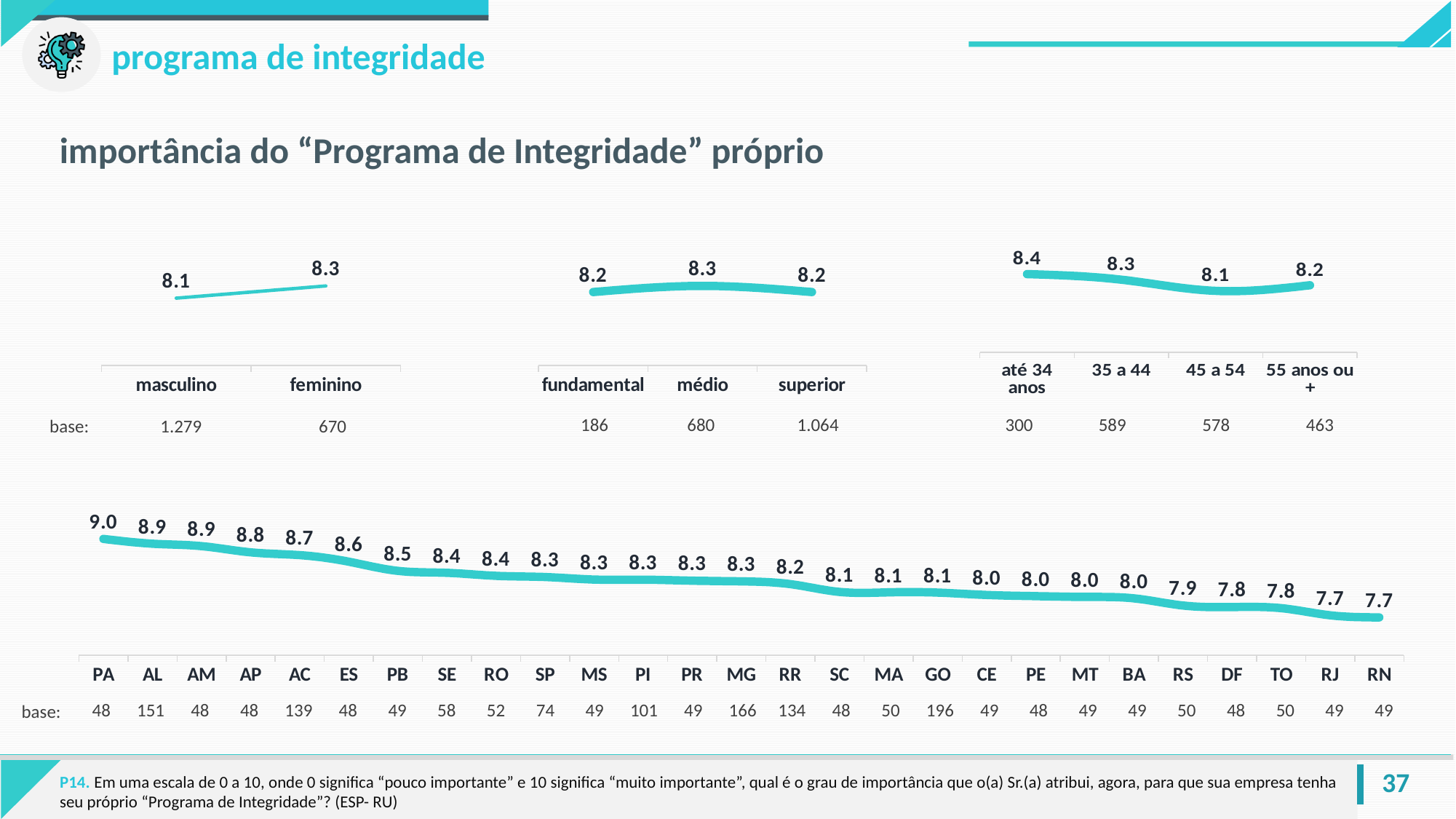
In the states chart at the bottom, how many states are plotted? 27 In the gender chart (masculino/feminino), what is the value for feminino? 8.3 In the gender chart, what is the difference between the feminino and masculino values? 0.2 In the age chart, how many age groups are plotted? 4 In the education chart (fundamental/médio/superior), which category has the highest value? médio In the gender chart, which group has the higher value, masculino or feminino? feminino In the states chart at the bottom, do the values rise or fall from left to right? fall In the states chart at the bottom, which state has the highest value? PA In the age chart, which age group has the highest value? até 34 anos In the states chart at the bottom, what is the value for SP? 8.3 In the age chart, which age group has the lowest value? 45 a 54 In the education chart, what is the value for superior? 8.2